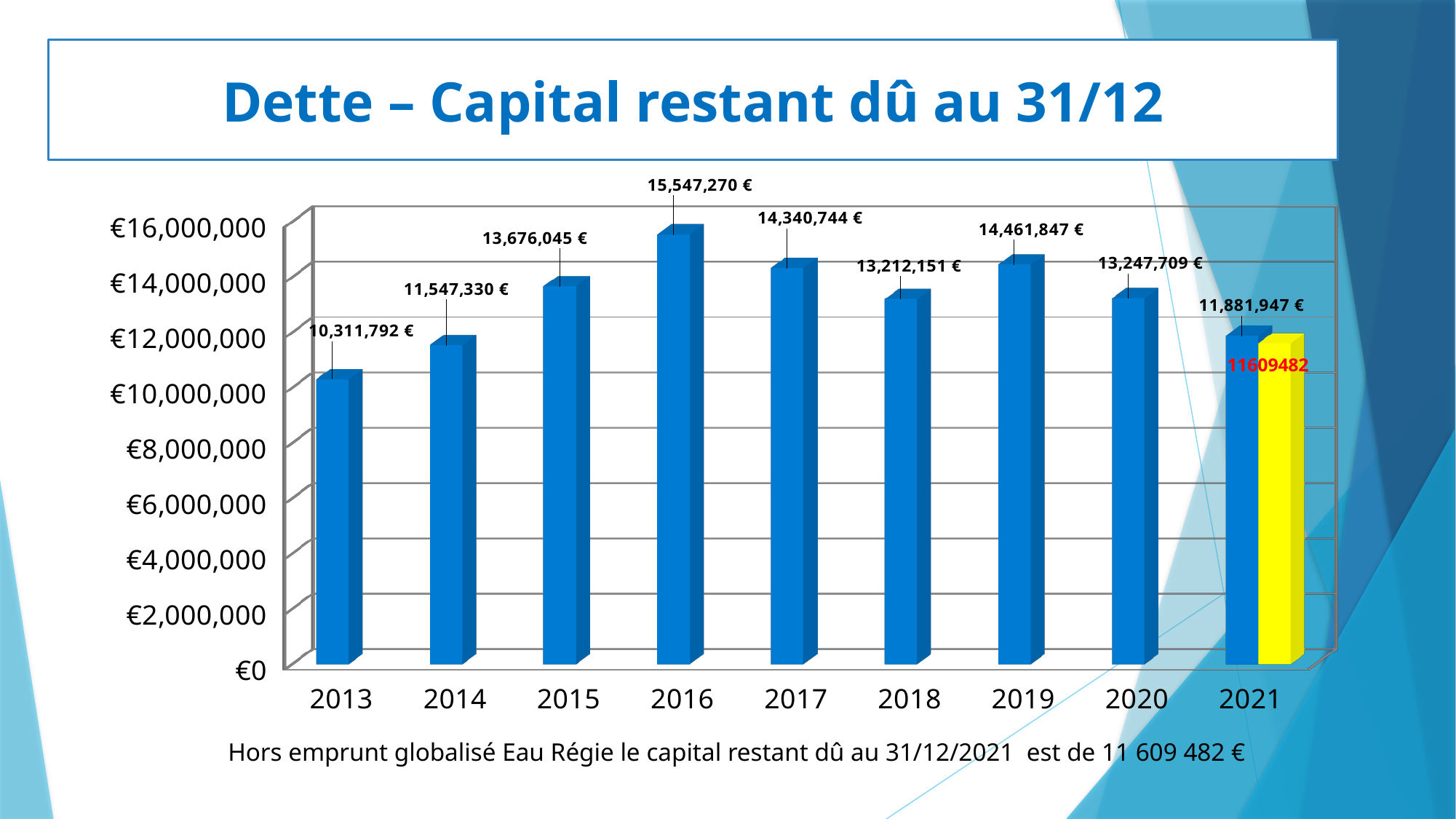
Which year has the lowest capital restant dû? 2013 Which is larger, the value for 2017 or the value for 2019? 2019 What is the value shown for 2020? 13,247,709 € What value is printed on the yellow bar for 2021? 11609482 Is the value for 2018 greater or less than €12,000,000? greater What is the difference between the values for 2016 and 2015? 1,871,225 € Which year has the highest capital restant dû? 2016 What kind of chart is shown on the slide? bar chart What is the value shown for 2013? 10,311,792 € How many years are shown on the x axis? 9 Do the values rise or fall from 2013 to 2016? rise What is the value shown for 2016? 15,547,270 €